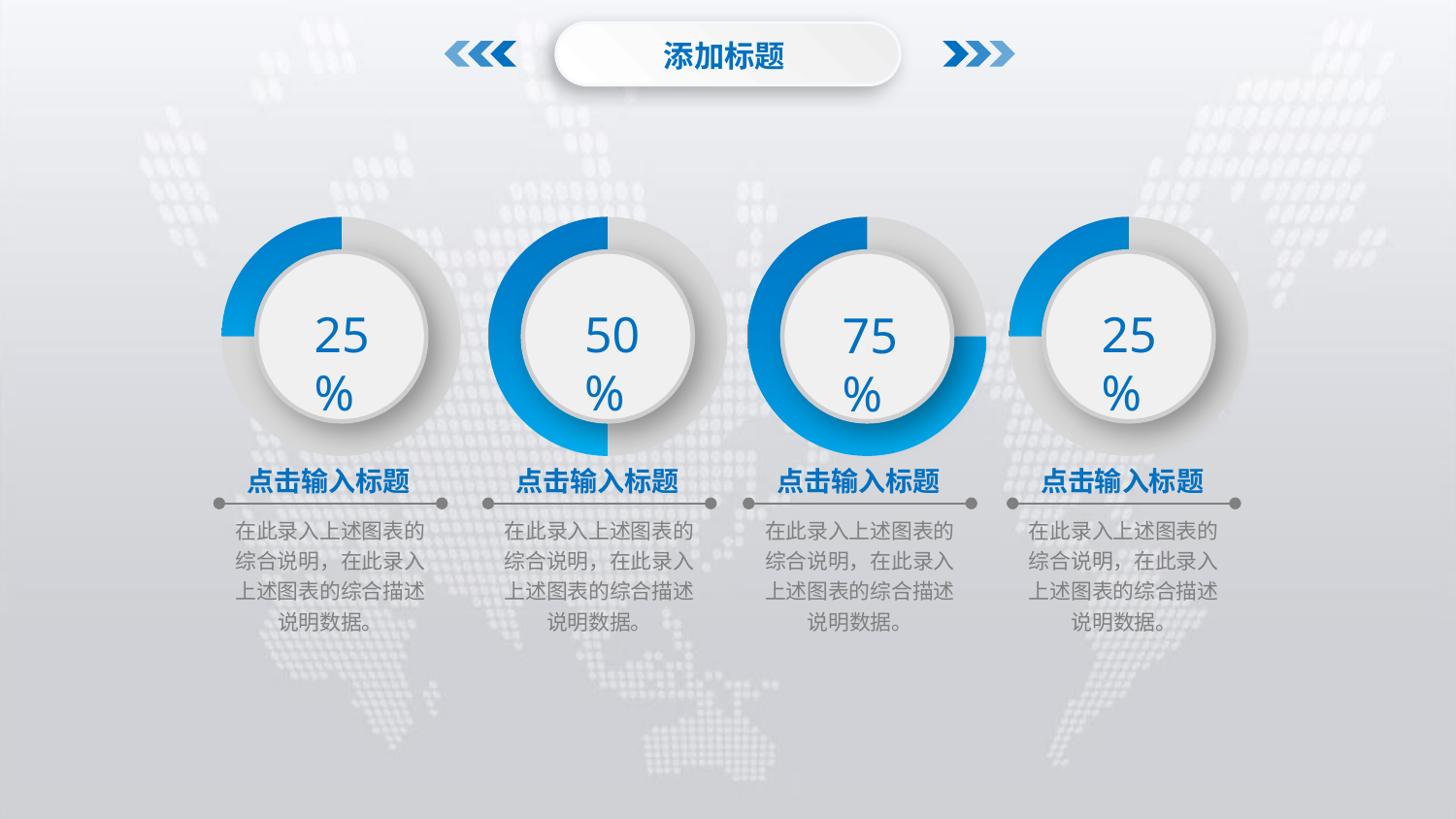
What is the difference between the value in the third ring chart and the value in the leftmost ring chart? 50% Which of the four ring charts shows the highest percentage? The third from the left (75%) What is the difference between the value in the second ring chart and the value in the rightmost ring chart? 25% How many ring charts are shown on the slide? 4 What kind of chart is used to display the percentages on the slide? Donut (ring) chart Which is larger, the value in the second ring chart or the value in the third ring chart? The third ring chart (75%) What value is shown in the third ring chart from the left? 75% What value is shown in the leftmost ring chart? 25% What is the title text shown at the top of the slide? 添加标题 What value is shown in the rightmost ring chart? 25% What colour is used for the filled portion of each ring chart? Blue What value is shown in the second ring chart from the left? 50%